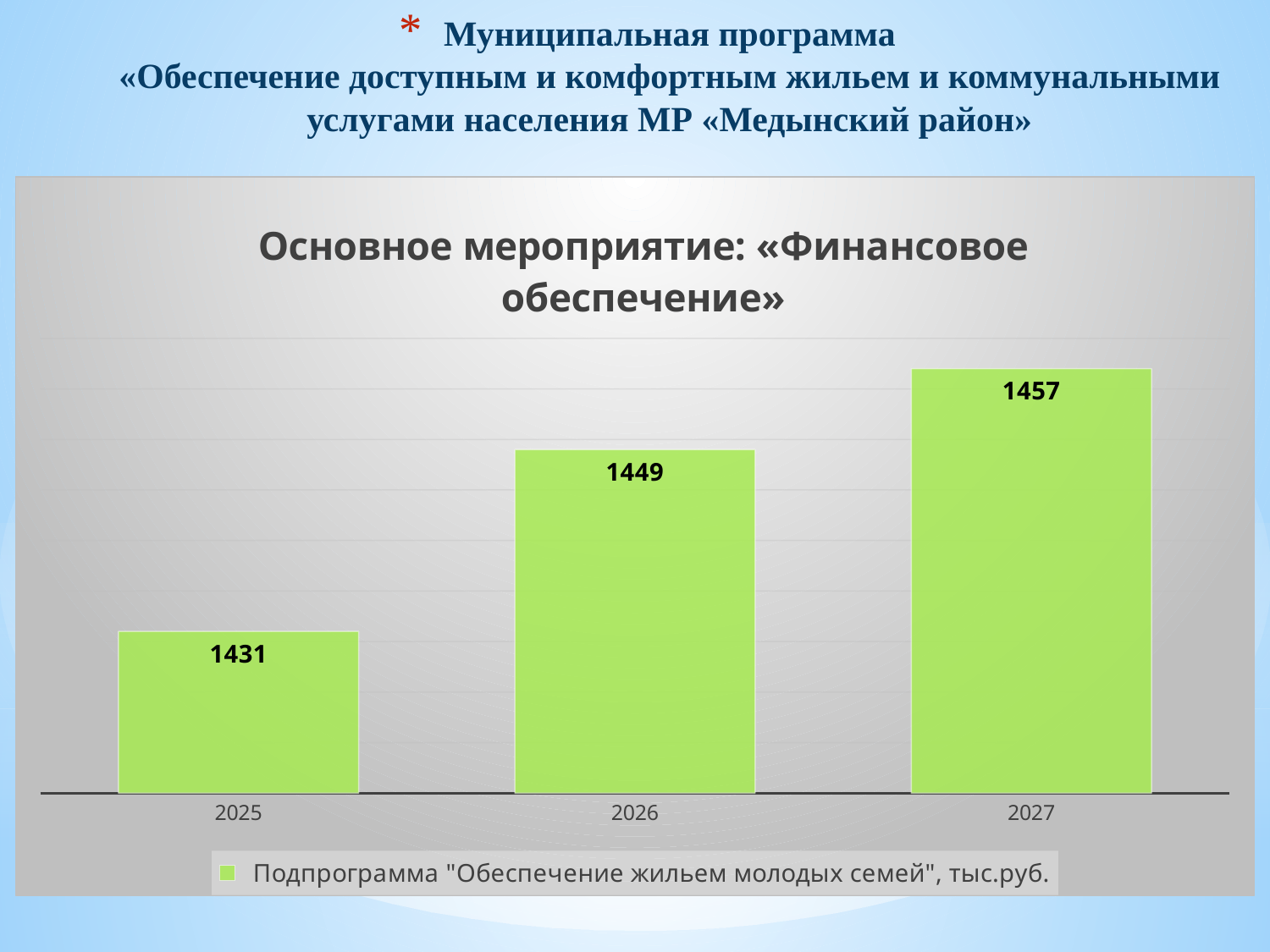
What is the value for 2026? 1449 What is the difference between the values for 2026 and 2025? 18 What is the difference between the values for 2027 and 2025? 26 What is the value for 2025? 1431 What kind of chart is shown? bar chart How many series does the legend list? 1 Which year has the lowest value? 2025 What is the value for 2027? 1457 Which year has the highest value? 2027 Do the values rise or fall from 2025 to 2027? rise Which is larger, the value for 2026 or the value for 2027? 2027 How many years are shown on the x axis? 3